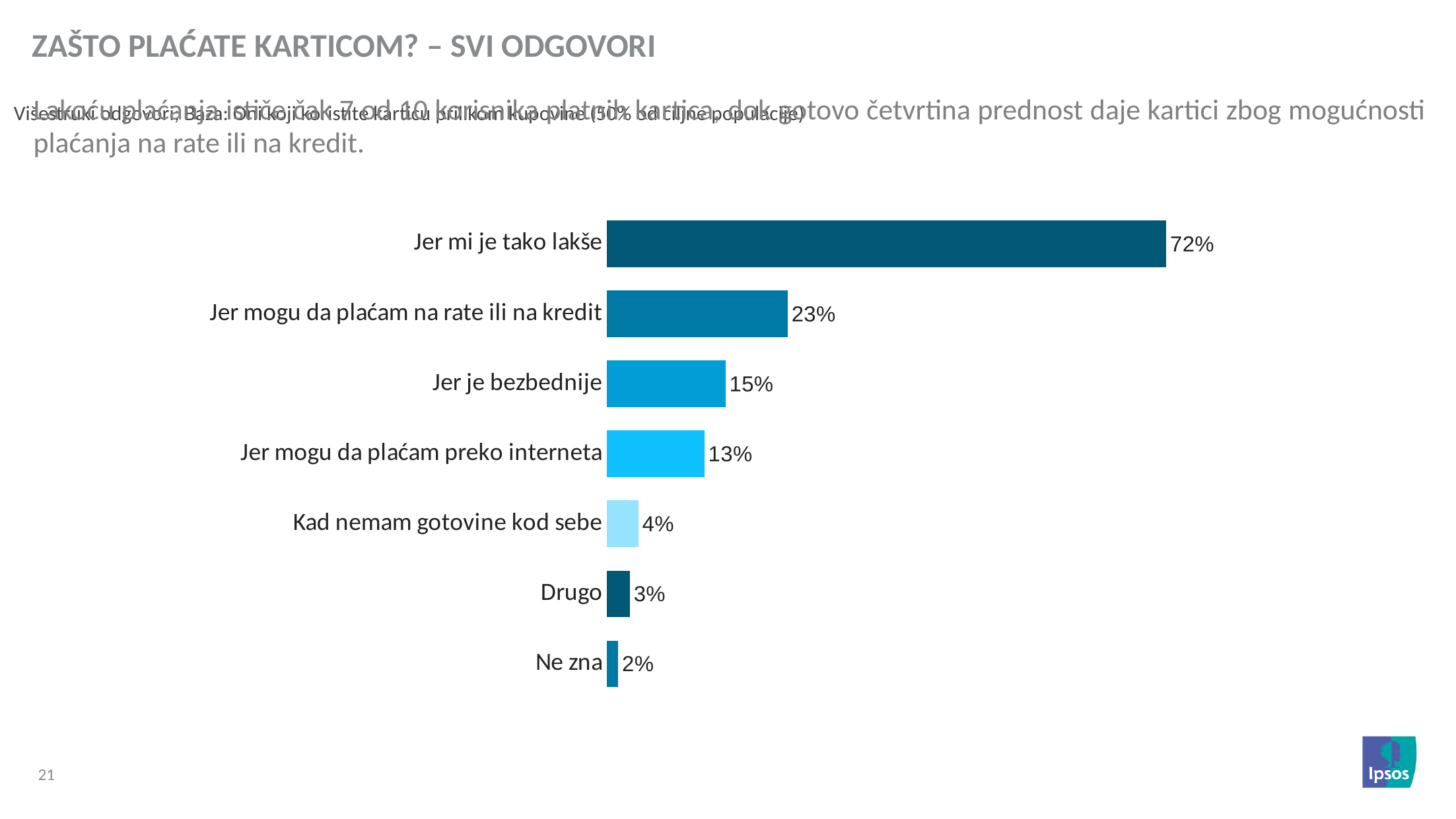
How many categories are shown in the chart? 7 What is the value for "Jer je bezbednije"? 15% What kind of chart is shown on the slide? Bar chart Which is larger, "Drugo" or "Kad nemam gotovine kod sebe"? Kad nemam gotovine kod sebe What is the difference between "Jer je bezbednije" and "Jer mogu da plaćam preko interneta"? 2% What is the value for "Jer mogu da plaćam na rate ili na kredit"? 23% What is the value for "Jer mi je tako lakše"? 72% Which category has the lowest value? Ne zna What is the value for "Kad nemam gotovine kod sebe"? 4% Which category has the highest value? Jer mi je tako lakše What is the difference between "Jer mi je tako lakše" and "Jer mogu da plaćam na rate ili na kredit"? 49% What is the value for "Drugo"? 3%